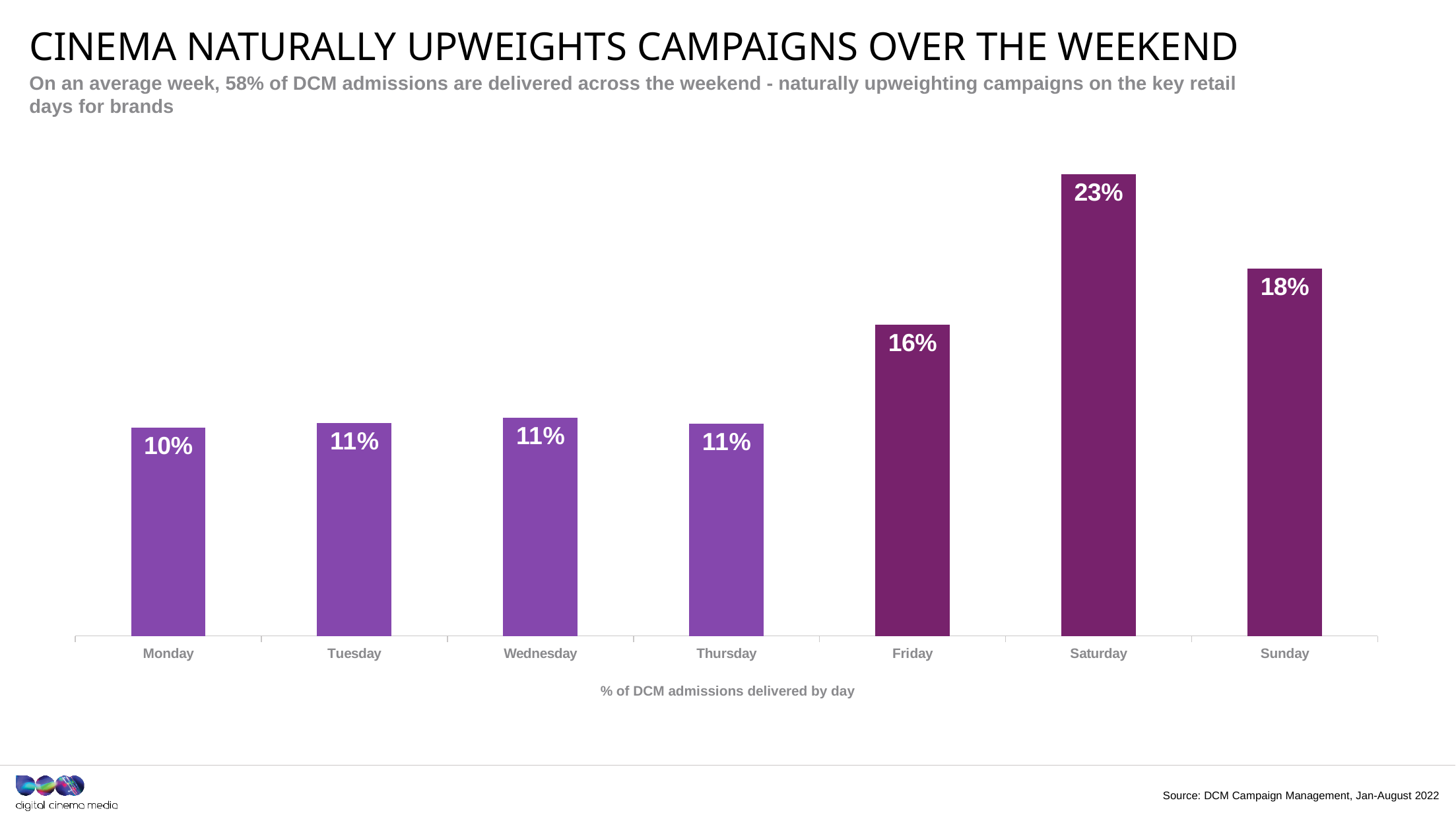
What percentage of DCM admissions is delivered on Friday? 16% What kind of chart is shown on the slide? Bar chart Which day has the lowest share of DCM admissions? Monday What percentage of DCM admissions is delivered on Saturday? 23% What percentage of DCM admissions is delivered on Monday? 10% What is the difference between the Saturday and Sunday values? 5% What is the x-axis label of the chart? % of DCM admissions delivered by day How many days are shown on the x axis of the chart? 7 Which day has the highest share of DCM admissions? Saturday What is the difference between the Friday and Monday values? 6% Which is larger, the value for Friday or the value for Sunday? Sunday What percentage of DCM admissions is delivered on Sunday? 18%